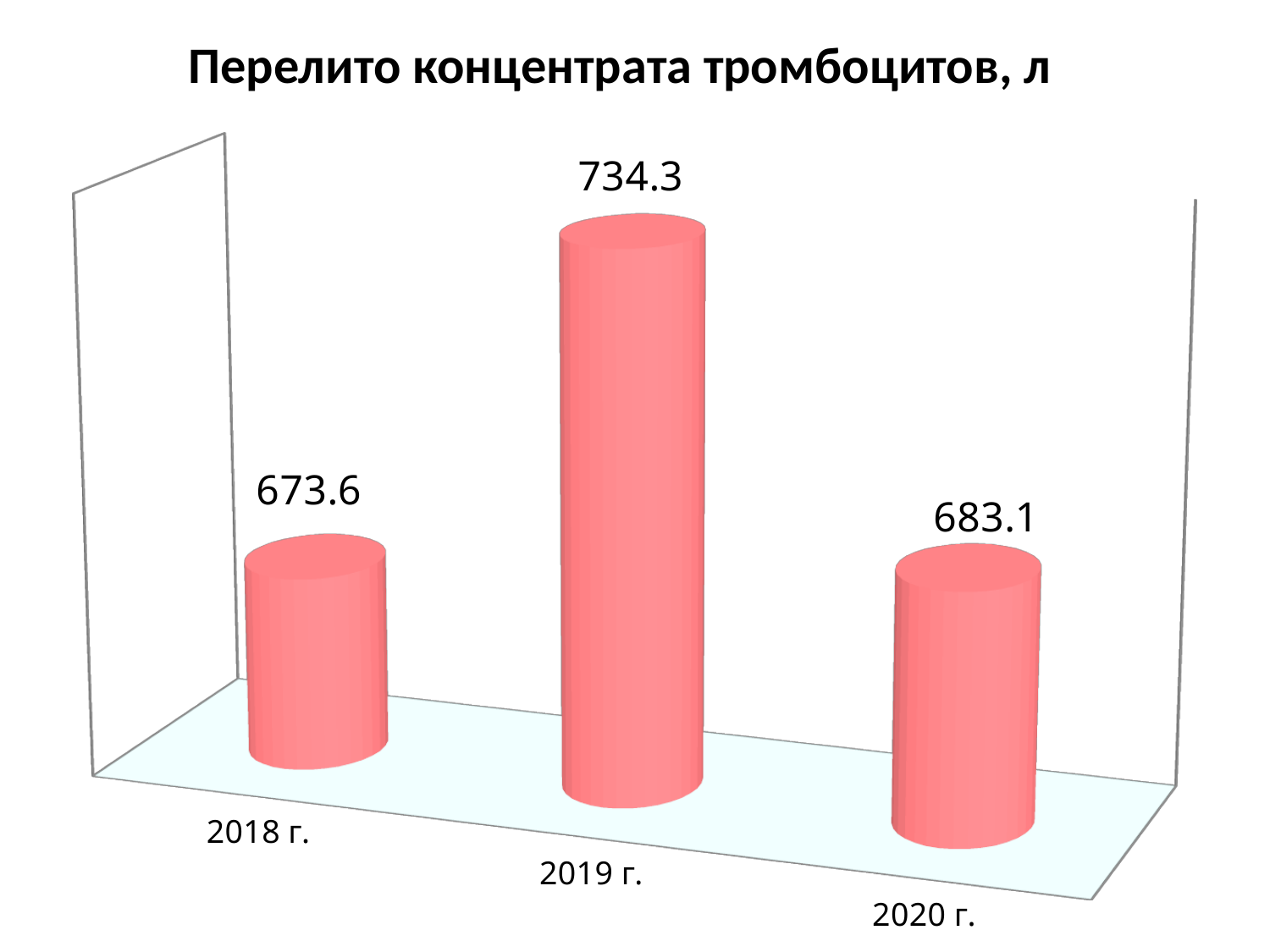
What is the value for 2020 г.? 683.1 Which is larger, the value for 2019 г. or the value for 2020 г.? 2019 г. What is the value for 2018 г.? 673.6 How many categories are shown on the chart? 3 What is the value for 2019 г.? 734.3 What is the title of the chart? Перелито концентрата тромбоцитов, л What is the difference between the values for 2020 г. and 2018 г.? 9.5 Which year has the highest value? 2019 г. What kind of chart is this? bar chart What is the difference between the values for 2019 г. and 2020 г.? 51.2 Which year has the lowest value? 2018 г. What is the difference between the values for 2019 г. and 2018 г.? 60.7